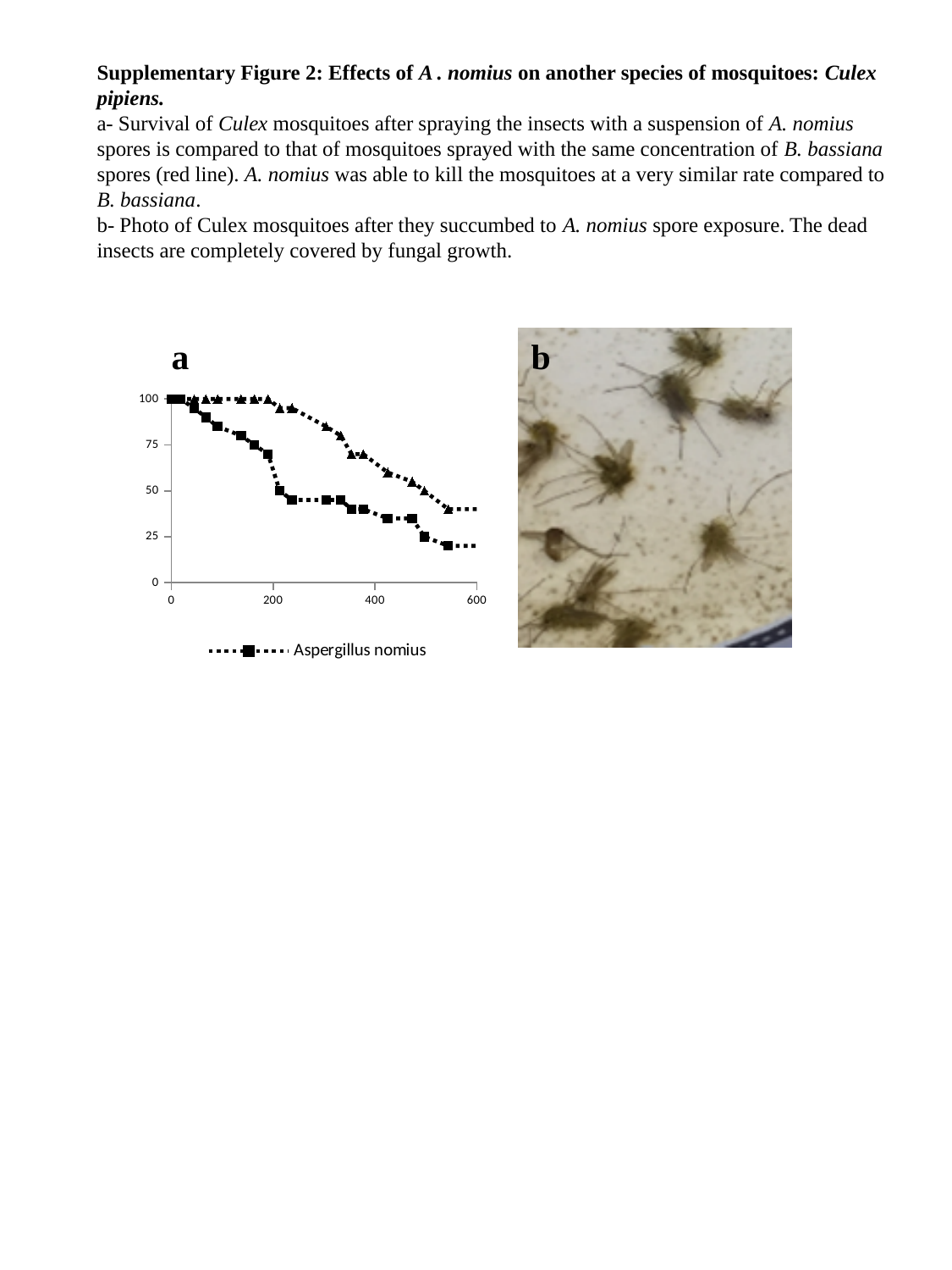
In the chart in panel a, is the Aspergillus nomius value at x = 600 greater or less than 25? less How many series does the legend of the chart in panel a list? 1 In the chart in panel a, is the value of the triangle-marker series at x = 400 greater or less than 50? greater In the chart in panel a, what is the Aspergillus nomius value at x = 0? 100 What is the highest tick value shown on the y axis of the chart in panel a? 100 What kind of chart is panel a? line chart In the chart in panel a, is the Aspergillus nomius value at x = 400 greater or less than 50? less In the chart in panel a, do the Aspergillus nomius values rise or fall as the x axis increases? fall In the chart in panel a, at x = 400, which series has the higher value: the Aspergillus nomius (square-marker) series or the triangle-marker series? the triangle-marker series What series name is shown in the legend of the chart in panel a? Aspergillus nomius